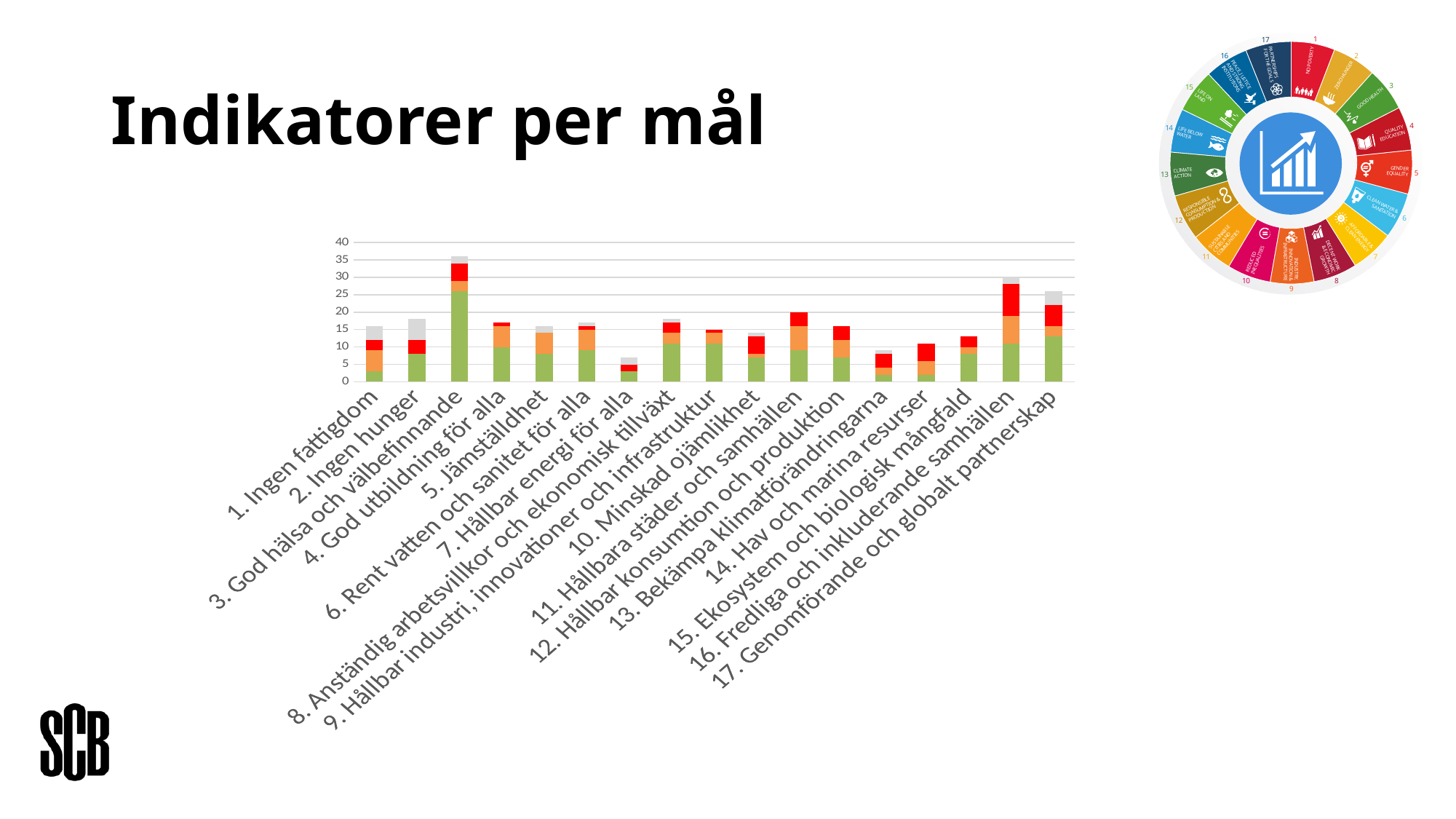
Which bar is taller: "11. Hållbara städer och samhällen" or "10. Minskad ojämlikhet"? 11. Hållbara städer och samhällen Which category has the tallest bar in the chart? 3. God hälsa och välbefinnande Which category has the shortest bar in the chart? 7. Hållbar energi för alla What is the title of the slide containing the chart? Indikatorer per mål Which bar is taller: "16. Fredliga och inkluderande samhällen" or "17. Genomförande och globalt partnerskap"? 16. Fredliga och inkluderande samhällen Is the total value for "17. Genomförande och globalt partnerskap" greater or less than 20? greater Is the total value for "3. God hälsa och välbefinnande" greater or less than 30? greater How many categories (goals) are shown on the x axis of the chart? 17 Is the total value for "16. Fredliga och inkluderande samhällen" greater or less than 25? greater What kind of chart is shown on the slide? Stacked bar chart